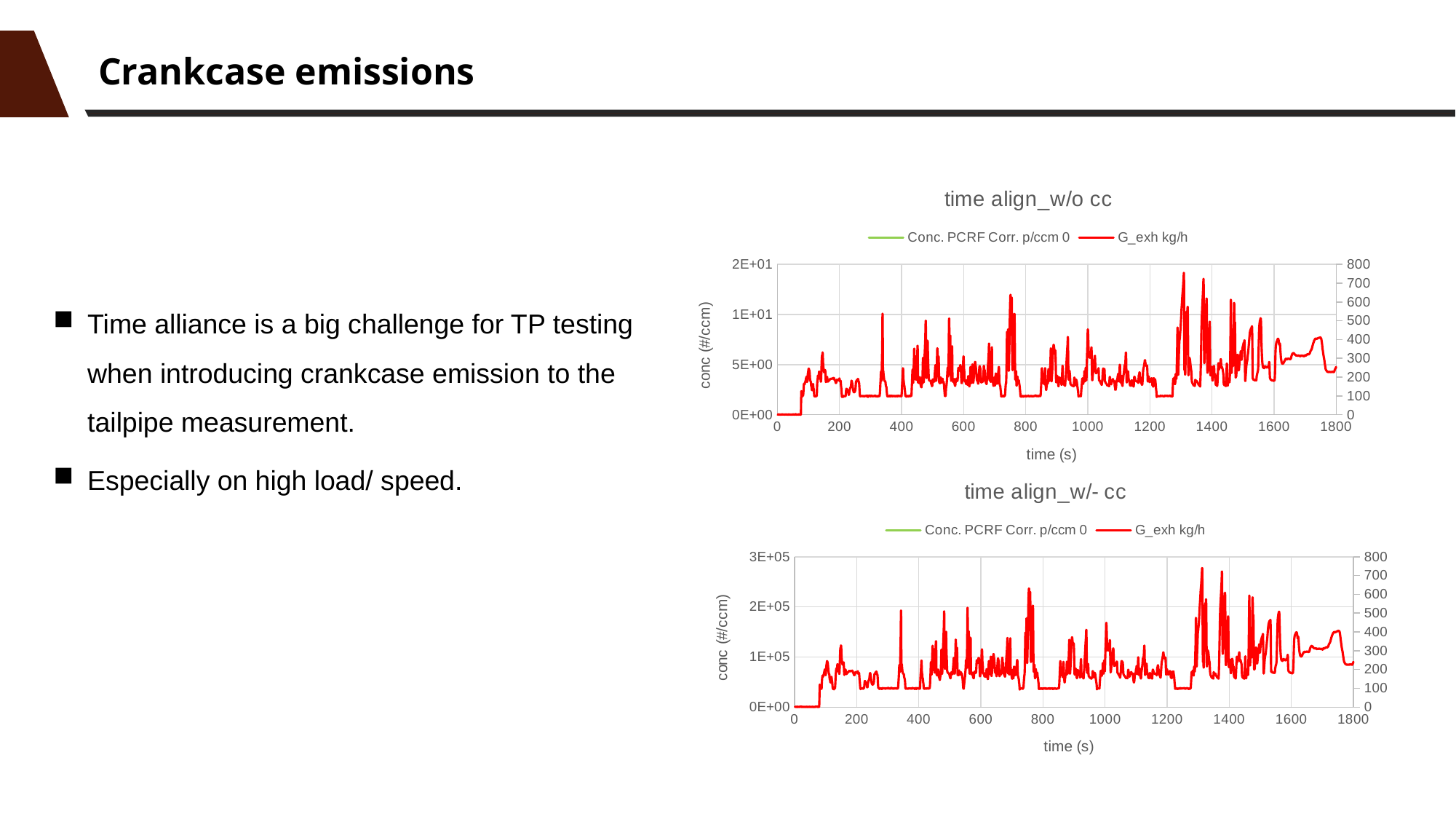
In the bottom chart "time align_w/- cc", is the highest peak of the G_exh kg/h series greater or less than 600 on the right-hand axis? greater In the top chart "time align_w/o cc", is the value of G_exh kg/h at around 1700 s greater or less than 200 on the right-hand axis? greater In the top chart "time align_w/o cc", is the highest peak of the G_exh kg/h series greater or less than 800 on the right-hand axis? less How many series does the legend of the top chart "time align_w/o cc" list? 2 How many series does the legend of the bottom chart "time align_w/- cc" list? 2 What kind of chart is the top chart titled "time align_w/o cc"? line chart What is the title of the upper chart on the slide? time align_w/o cc What kind of chart is the bottom chart titled "time align_w/- cc"? line chart In the bottom chart "time align_w/- cc", what is the label of the x axis? time (s)